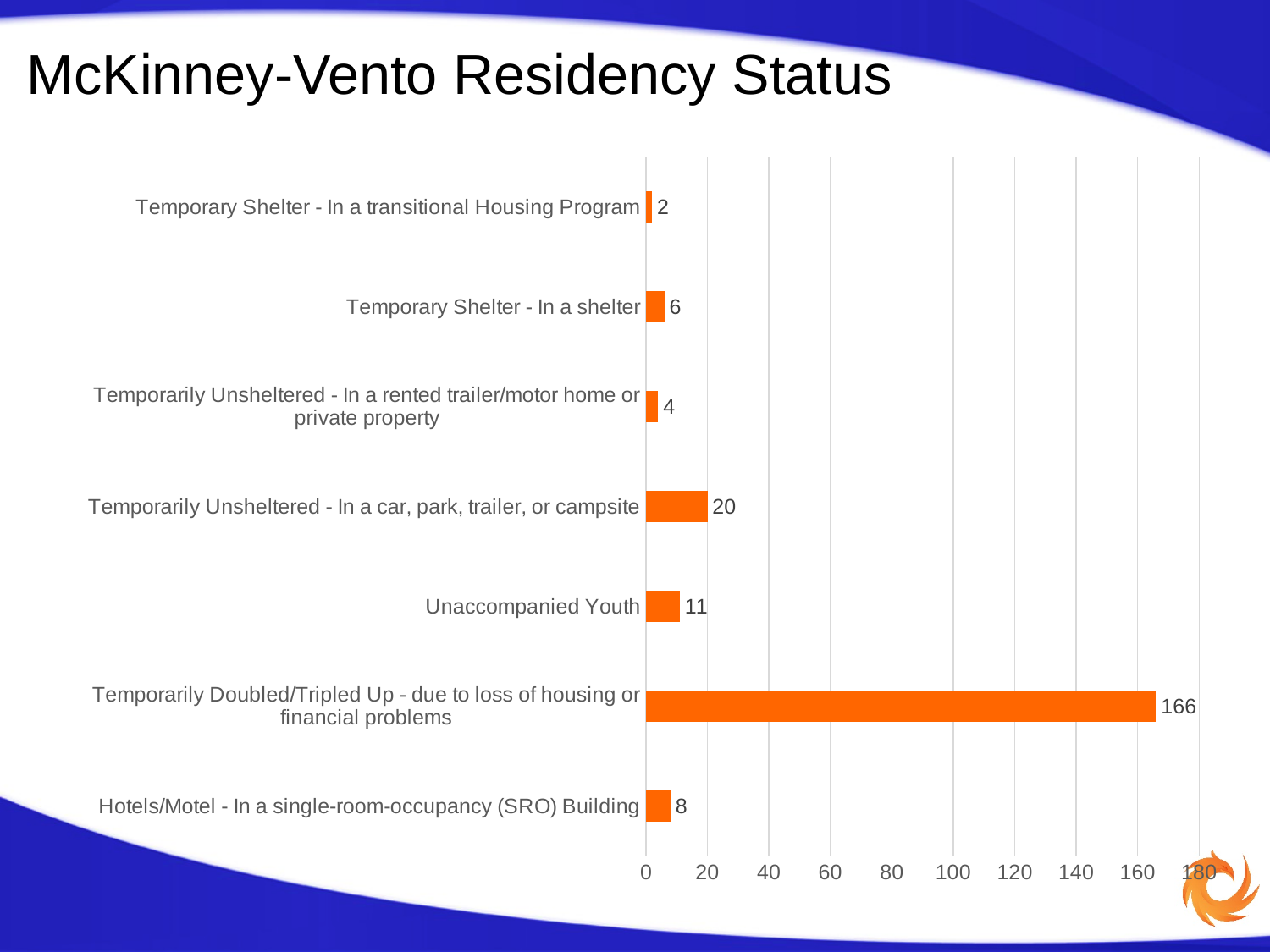
What is the value for Temporarily Unsheltered - In a car, park, trailer, or campsite? 20 Which category has the highest value? Temporarily Doubled/Tripled Up - due to loss of housing or financial problems What is the difference between the value for Temporarily Doubled/Tripled Up and the value for Temporarily Unsheltered - In a car, park, trailer, or campsite? 146 What is the value for Unaccompanied Youth? 11 How many categories are shown in the chart? 7 What is the value for Hotels/Motel - In a single-room-occupancy (SRO) Building? 8 Which is larger: the value for Unaccompanied Youth or the value for Hotels/Motel - In a single-room-occupancy (SRO) Building? Unaccompanied Youth Is the value for Temporarily Doubled/Tripled Up greater or less than 160? greater What is the title of the slide? McKinney-Vento Residency Status What kind of chart is shown on the slide? bar chart Which category has the lowest value? Temporary Shelter - In a transitional Housing Program What is the value for Temporary Shelter - In a shelter? 6